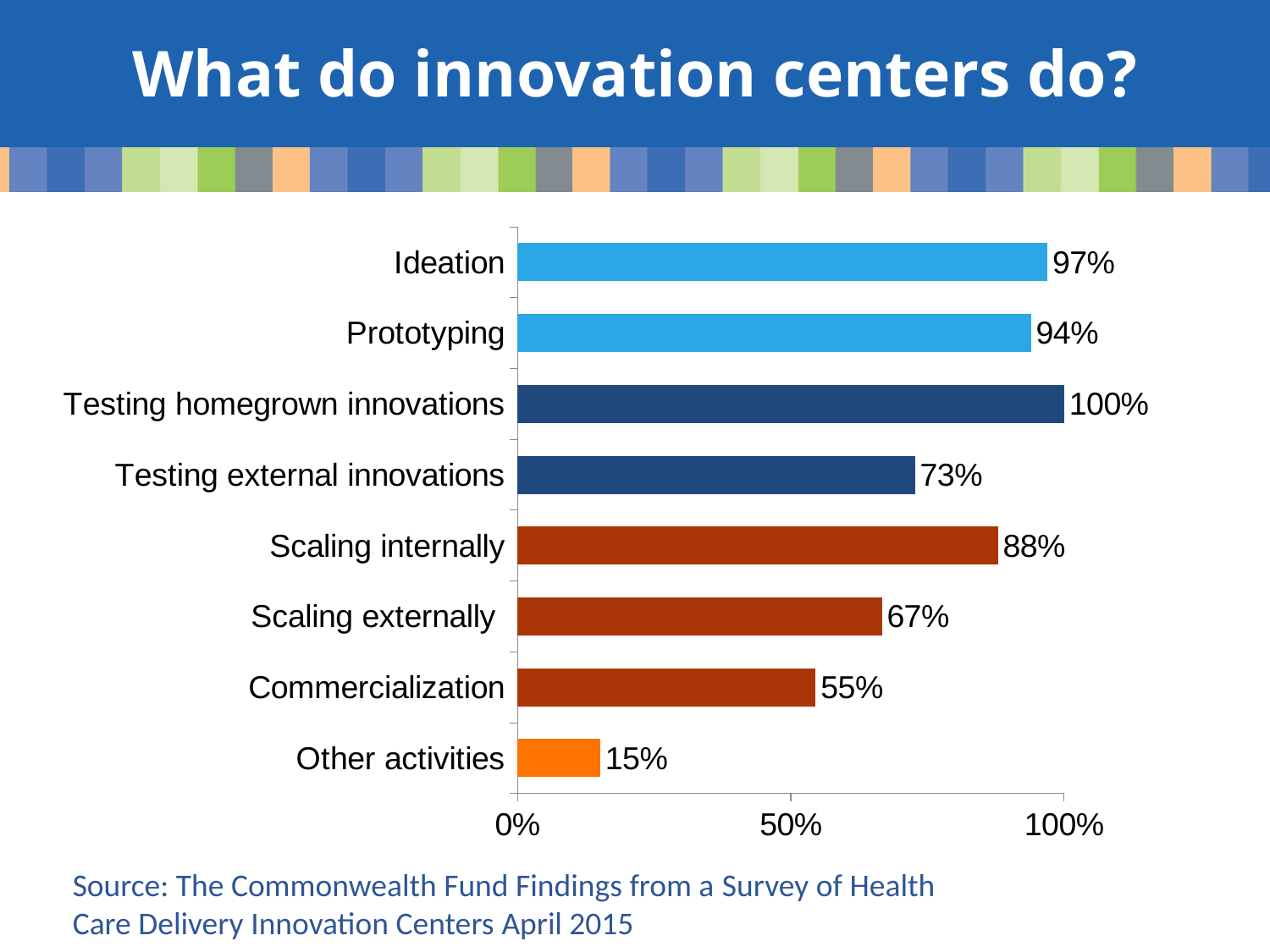
What is the value for Commercialization? 55% What is the value for Ideation? 97% Which category has the highest value? Testing homegrown innovations What is the difference between the values for Scaling internally and Scaling externally? 21% How many categories are shown in the chart? 8 Is the value for Commercialization greater or less than 50%? greater Which is larger, the value for Prototyping or the value for Testing external innovations? Prototyping Which category has the lowest value? Other activities What is the title of the slide? What do innovation centers do? What is the value for Testing external innovations? 73% What colour is the bar for Other activities? Orange What kind of chart is shown on the slide? Bar chart